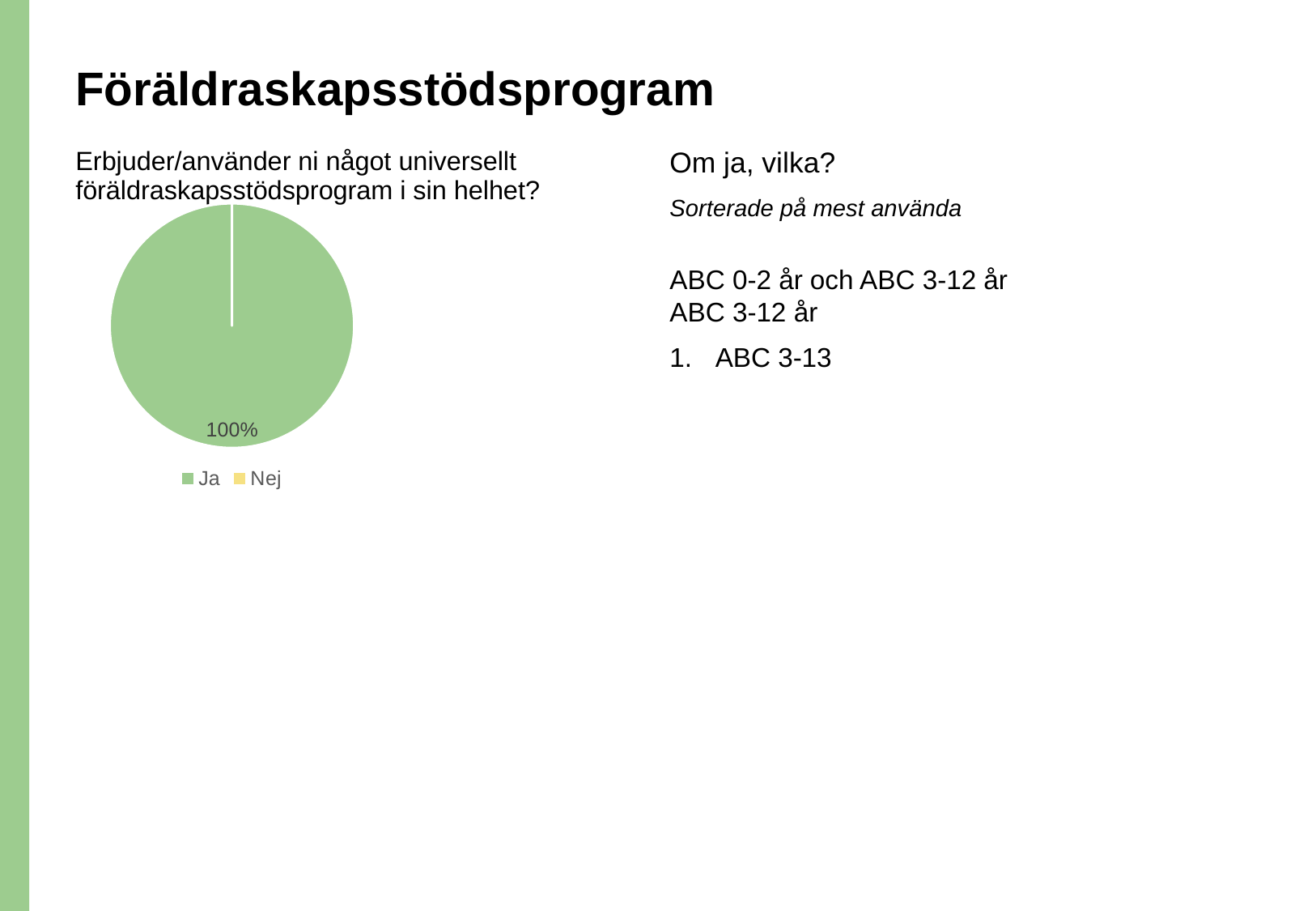
Which category has the largest share of the pie chart? Ja How many entries does the legend of the pie chart list? 2 Which is larger in the pie chart, "Ja" or "Nej"? Ja What are the two legend entries of the pie chart? Ja, Nej What colour is the "Ja" slice in the pie chart? green Which category has the smallest share of the pie chart? Nej What share of the pie does "Ja" have? 100% Is the share for "Ja" greater or less than 50%? greater What kind of chart is shown on the slide? pie chart